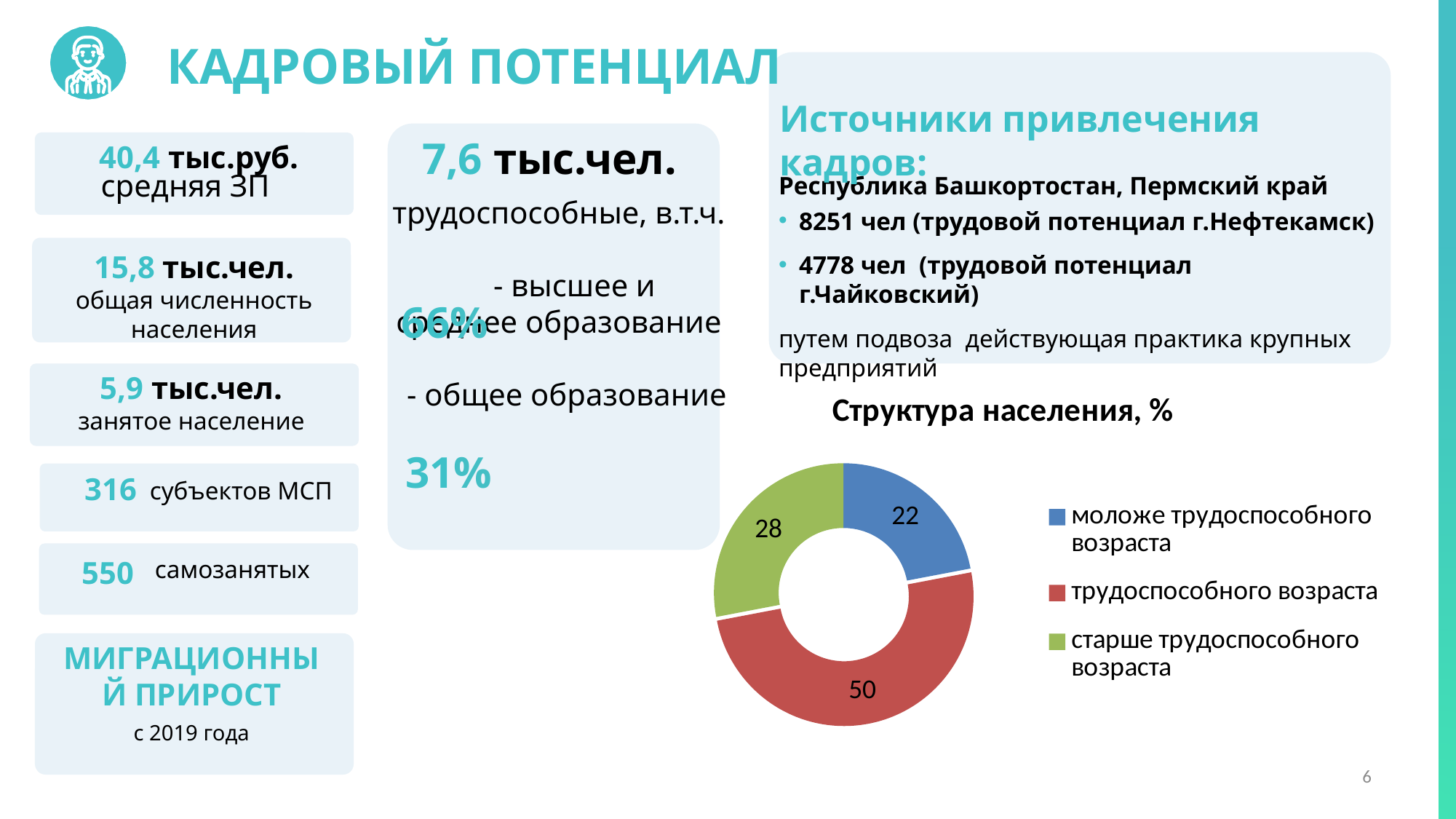
What value is shown for the 'моложе трудоспособного возраста' slice in the 'Структура населения, %' chart? 22 What kind of chart is 'Структура населения, %'? doughnut chart How many categories are shown in the 'Структура населения, %' chart? 3 What colour is the 'старше трудоспособного возраста' slice in the 'Структура населения, %' chart? green In the 'Структура населения, %' chart, which is larger: 'старше трудоспособного возраста' or 'моложе трудоспособного возраста'? старше трудоспособного возраста In the 'Структура населения, %' chart, what is the difference between the 'трудоспособного возраста' and 'старше трудоспособного возраста' values? 22 In the 'Структура населения, %' chart, what is the difference between the 'старше трудоспособного возраста' and 'моложе трудоспособного возраста' values? 6 What value is shown for the 'трудоспособного возраста' slice in the 'Структура населения, %' chart? 50 What value is shown for the 'старше трудоспособного возраста' slice in the 'Структура населения, %' chart? 28 Which category has the smallest slice in the 'Структура населения, %' chart? моложе трудоспособного возраста What share of the 'Структура населения, %' chart does the 'трудоспособного возраста' slice represent? 50% Which category has the largest slice in the 'Структура населения, %' chart? трудоспособного возраста